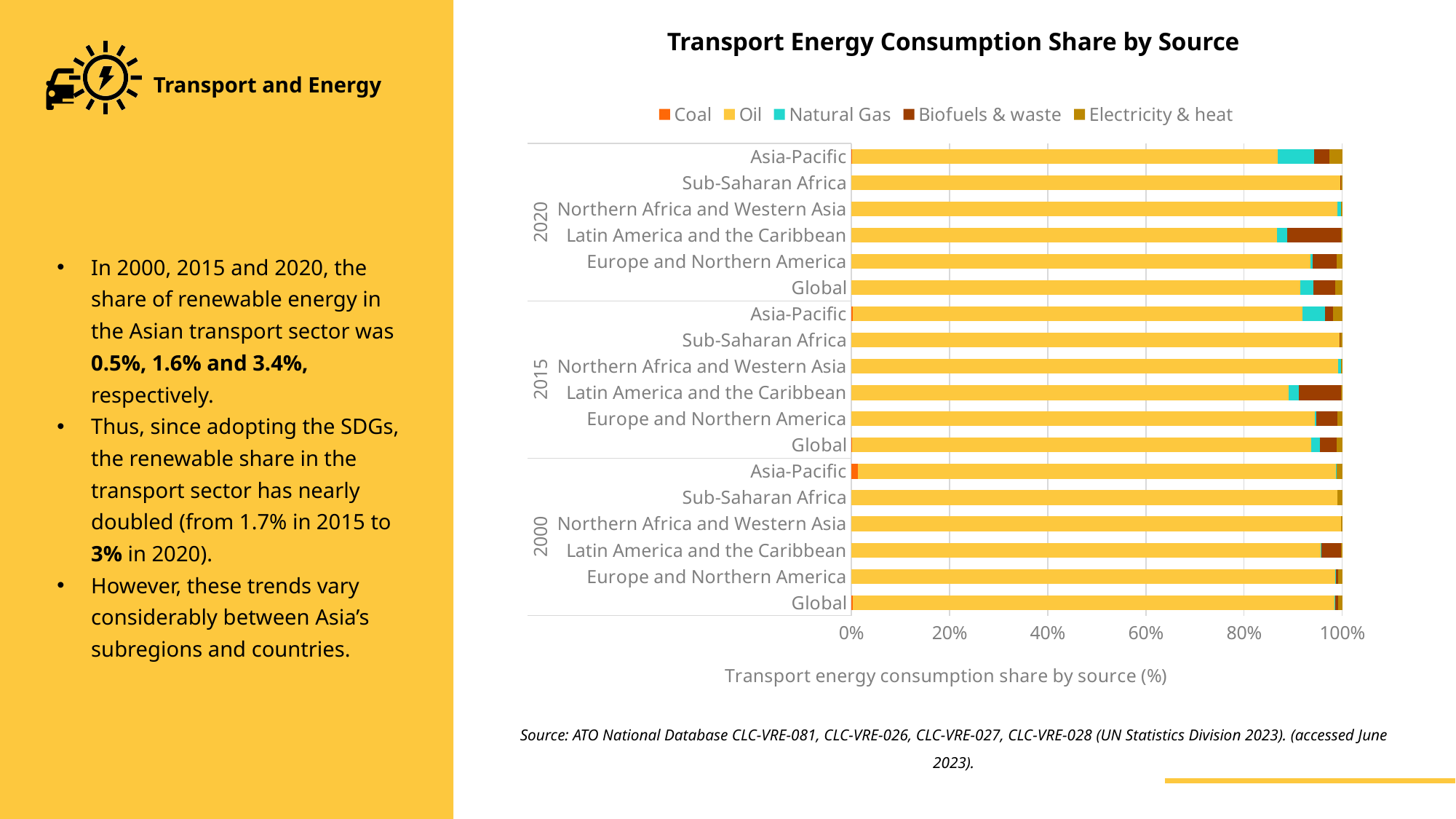
In 2020, which has the larger Oil share: Latin America and the Caribbean or Sub-Saharan Africa? Sub-Saharan Africa How many bars are plotted in the chart? 18 What kind of chart is shown on the slide? Stacked bar chart Is the Oil share for Latin America and the Caribbean in 2020 greater or less than 80%? greater What is the label on the horizontal axis of the chart? Transport energy consumption share by source (%) Does the Oil share for Latin America and the Caribbean rise or fall from 2000 to 2020? fall What is the title of the chart? Transport Energy Consumption Share by Source In 2020, which has the larger Biofuels & waste share: Latin America and the Caribbean or Europe and Northern America? Latin America and the Caribbean How many regions are shown for each year in the chart? 6 How many series does the legend list? 5 Is the Oil share for Sub-Saharan Africa in 2015 greater or less than 80%? greater Is the Oil share for Asia-Pacific in 2020 greater or less than 100%? less